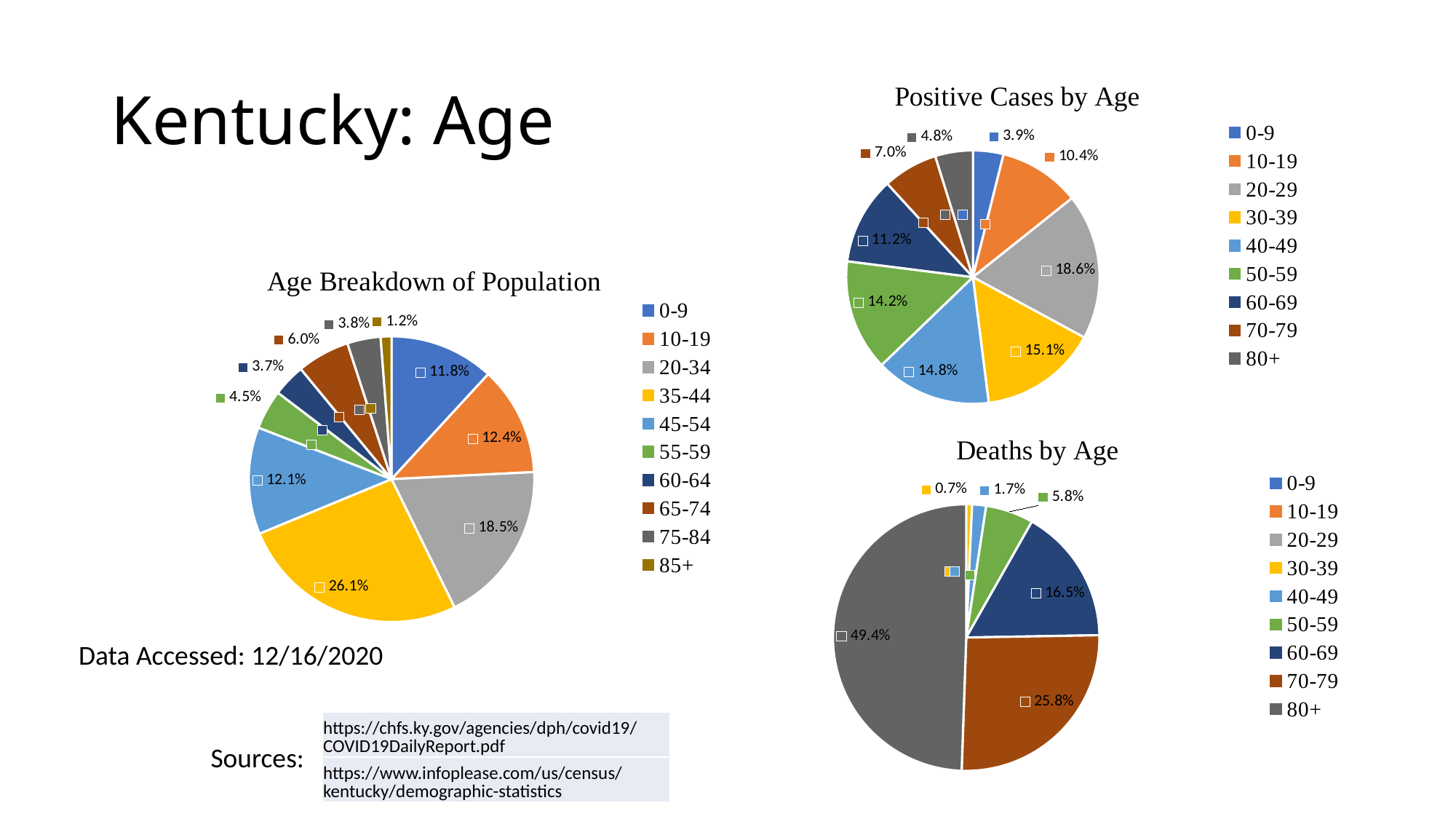
In the 'Age Breakdown of Population' chart, what share of the population is aged 35-44? 26.1% In the 'Deaths by Age' chart, what percentage of deaths are in the 80+ age group? 49.4% What type of chart is 'Deaths by Age'? Pie chart In the 'Age Breakdown of Population' chart, what is the difference between the 20-34 share and the 45-54 share? 6.4% In the 'Positive Cases by Age' chart, which is larger: the share for 60-69 or the share for 70-79? 60-69 In the 'Age Breakdown of Population' chart, how many age groups does the legend list? 10 In the 'Deaths by Age' chart, what is the difference between the 70-79 share and the 60-69 share? 9.3% In the 'Positive Cases by Age' chart, which age group has the smallest share of positive cases? 0-9 In the 'Age Breakdown of Population' chart, which age group has the smallest share? 85+ In the 'Positive Cases by Age' chart, what percentage of positive cases are in the 20-29 age group? 18.6% In the 'Positive Cases by Age' chart, which age group has the largest share of positive cases? 20-29 How many charts are shown on the slide? 3